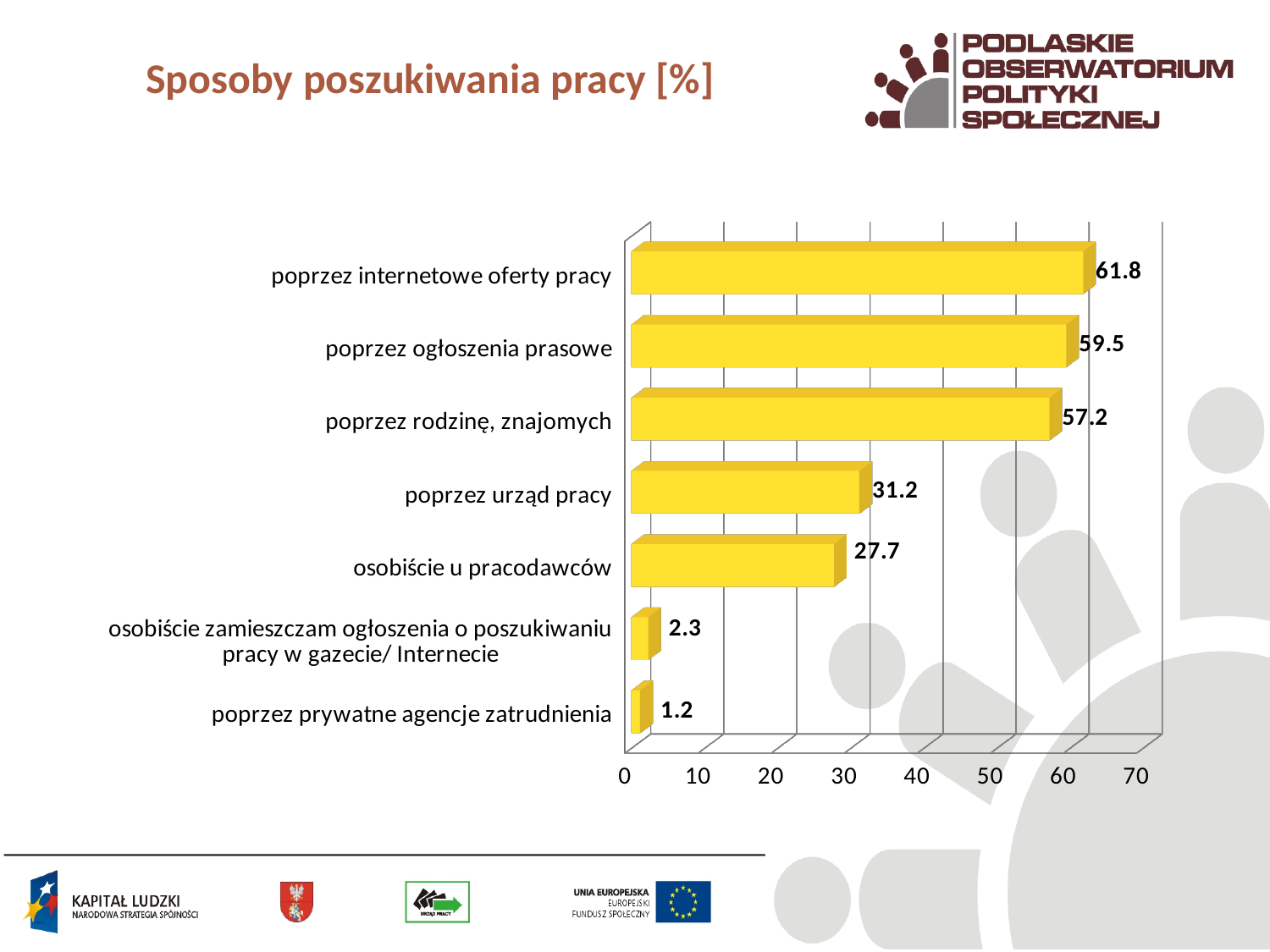
Which is larger: the value for "poprzez urząd pracy" or the value for "osobiście u pracodawców"? poprzez urząd pracy What is the difference between the values for "poprzez urząd pracy" and "osobiście u pracodawców"? 3.5 What is the value for "poprzez prywatne agencje zatrudnienia"? 1.2 How many categories are shown in the chart? 7 What is the value for "poprzez internetowe oferty pracy"? 61.8 What is the title of the chart on the slide? Sposoby poszukiwania pracy [%] What is the difference between the values for "poprzez ogłoszenia prasowe" and "poprzez rodzinę, znajomych"? 2.3 Which category has the lowest value? poprzez prywatne agencje zatrudnienia Which category has the highest value? poprzez internetowe oferty pracy Is the value for "poprzez rodzinę, znajomych" greater or less than 50? greater What is the value for "poprzez urząd pracy"? 31.2 What kind of chart is shown on the slide? bar chart